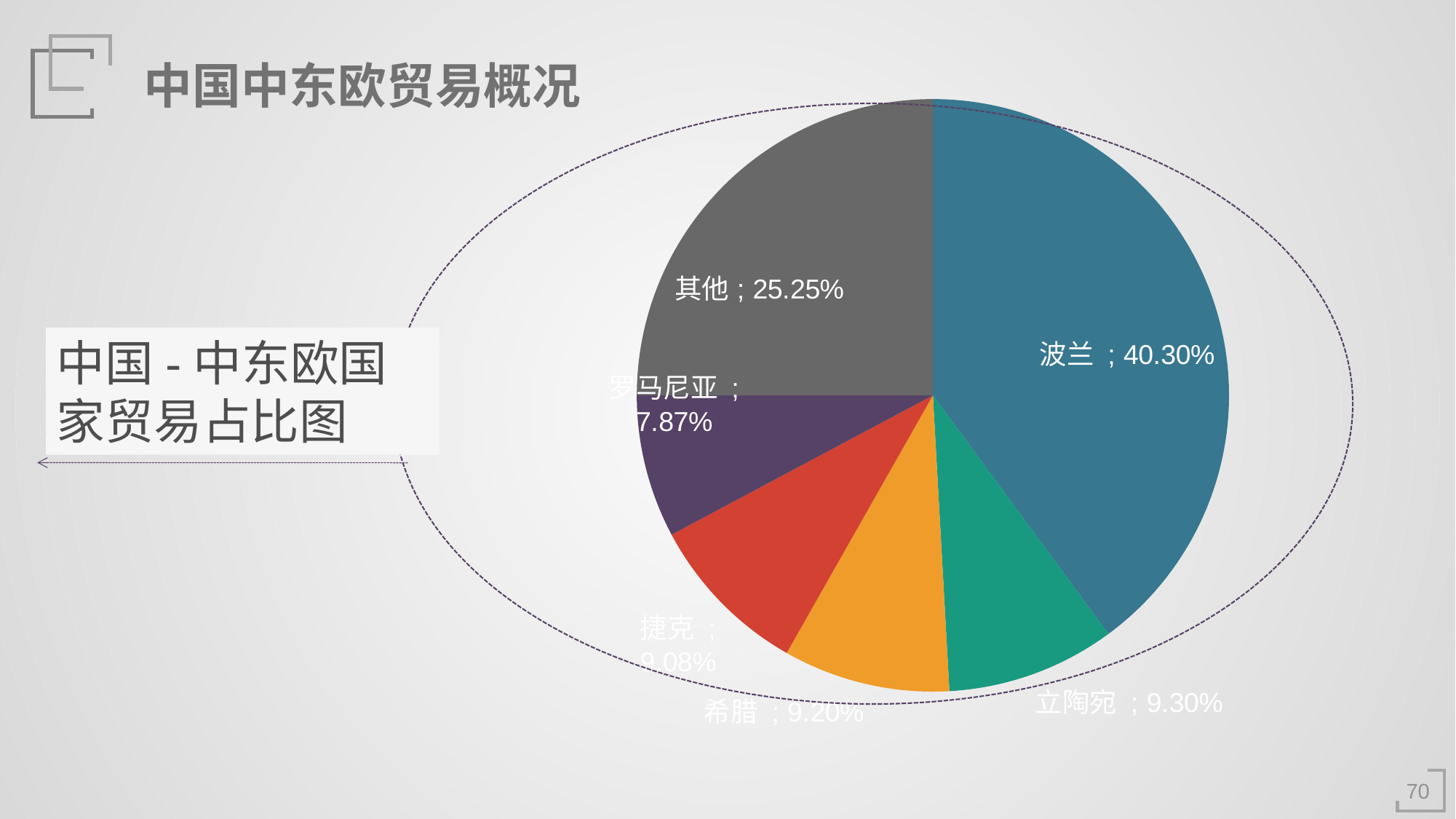
Which category has the largest slice of the pie? 波兰 Which is larger, the value for 立陶宛 or the value for 希腊? 立陶宛 What is the title of the chart shown in the text box on the left of the slide? 中国 - 中东欧国家贸易占比图 What is the value shown for 捷克? 9.08% How many slices does the pie chart have? 6 What is the value shown for 立陶宛? 9.30% What share of the pie does 波兰 hold? 40.30% Which category has the smallest slice of the pie? 罗马尼亚 What is the value shown for 罗马尼亚? 7.87% What is the value shown for 其他? 25.25% What kind of chart is shown on the slide? pie chart What is the difference between the values for 波兰 and 其他? 15.05%